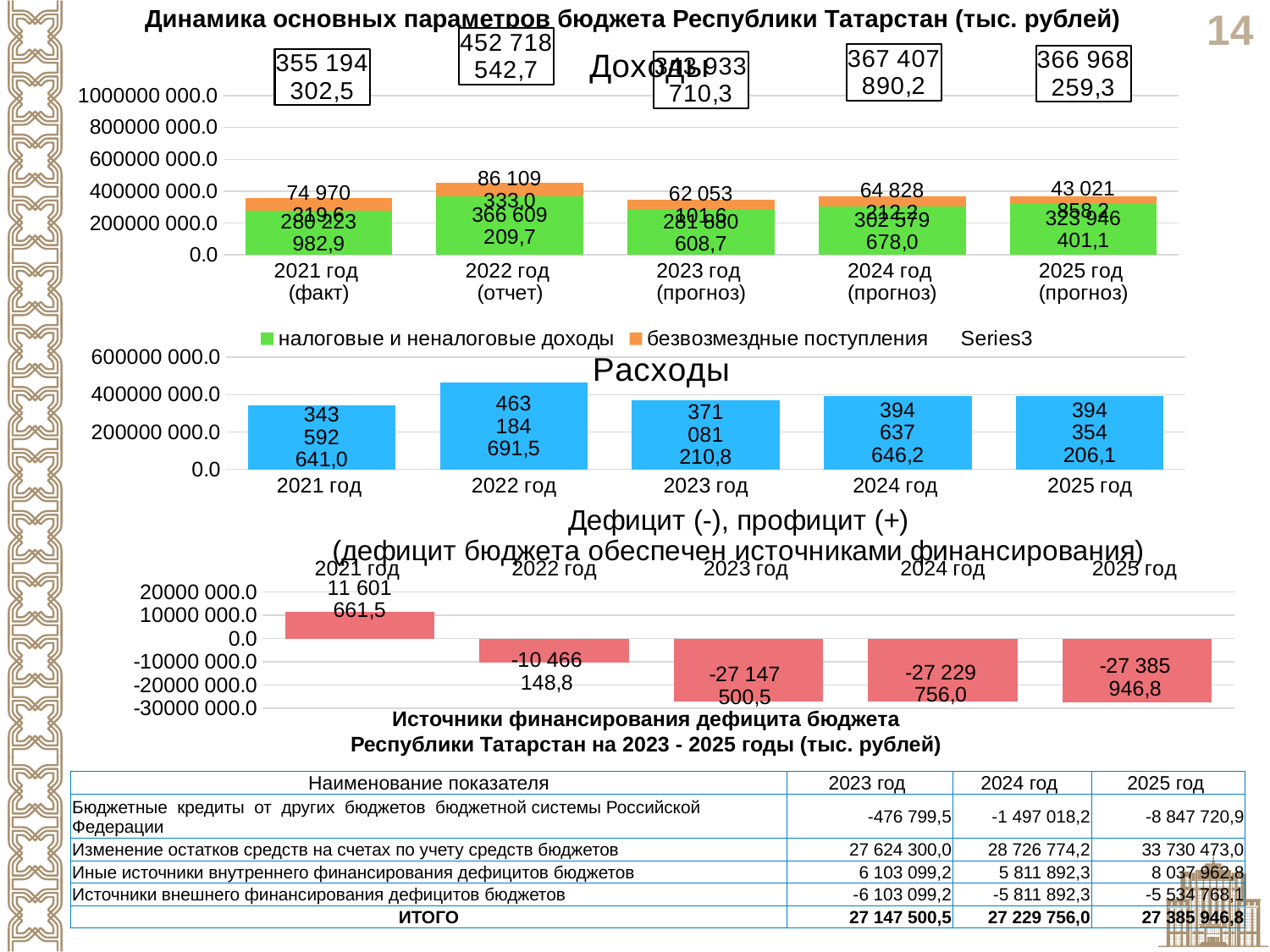
In the 'Расходы' chart, is the value for 2022 год greater or less than 400000 000.0? greater In the 'Расходы' chart, which year has the highest value? 2022 год In the 'Доходы' chart, what is the value of 'безвозмездные поступления' for 2022 год (отчет)? 86 109 333,0 In the 'Дефицит (-), профицит (+)' chart, what is the value for 2025 год? -27 385 946,8 In the 'Доходы' chart, which year has the highest total income? 2022 год (отчет) In the 'Расходы' chart, which year has the lowest value? 2021 год How many years are shown in the 'Дефицит (-), профицит (+)' chart? 5 In the 'Расходы' chart, what is the value for 2022 год? 463 184 691,5 How many series does the legend of the 'Доходы' chart list? 3 In the 'Дефицит (-), профицит (+)' chart, what is the value for 2021 год? 11 601 661,5 In the 'Дефицит (-), профицит (+)' chart, which year has the lowest value? 2025 год In the 'Расходы' chart, what is the difference between the values for 2022 год and 2021 год? 119 592 050,5